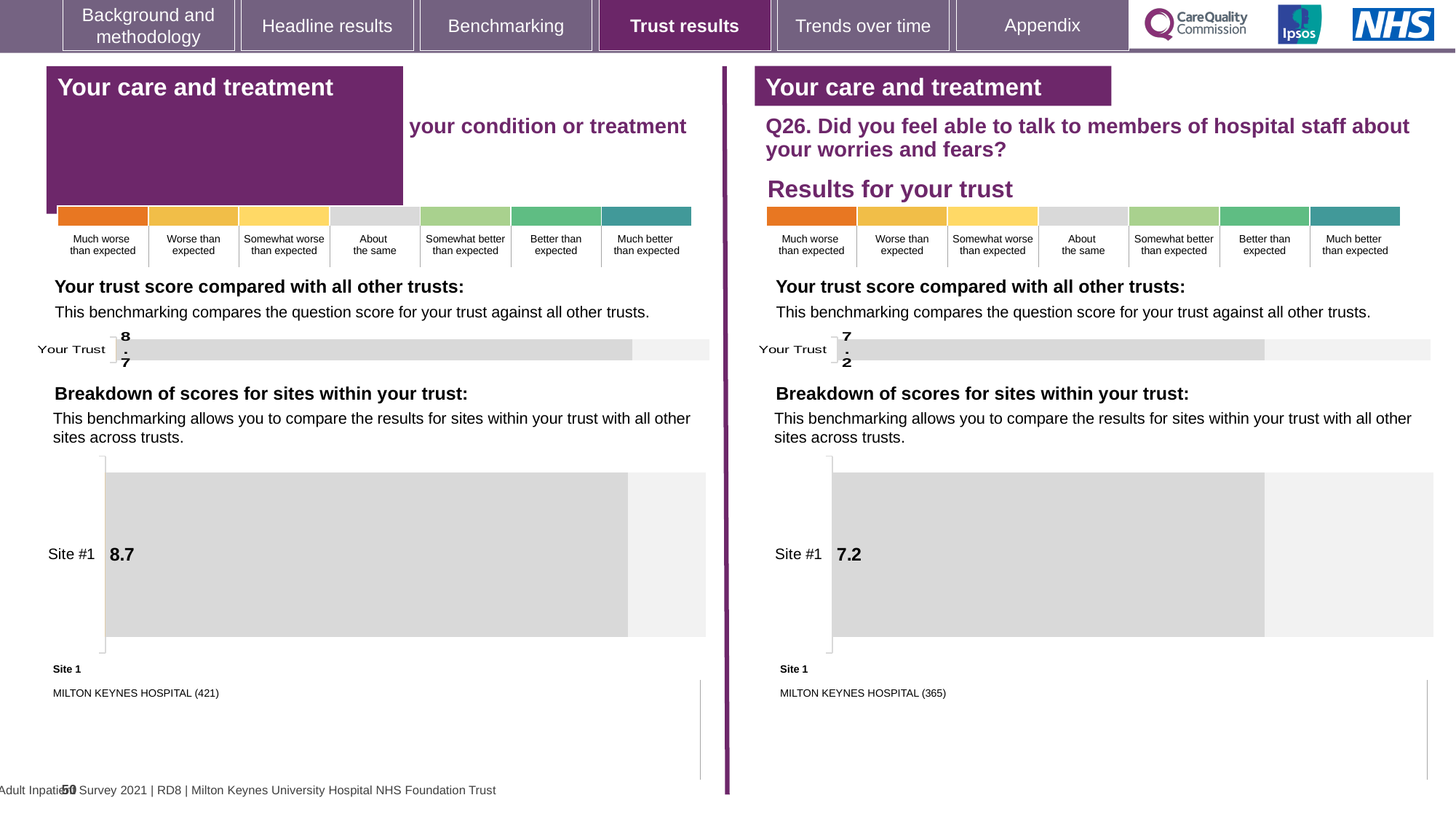
How many sites are shown in the 'Breakdown of scores for sites within your trust' chart on the left panel? 1 On the left panel, what is the score for Site #1 in the 'Breakdown of scores for sites within your trust' chart? 8.7 What type of chart is used to show the Site #1 score on the right panel (Q26)? Bar chart What is the question number and text shown above the charts on the right panel? Q26. Did you feel able to talk to members of hospital staff about your worries and fears? What is the difference between the Site #1 score on the left panel and the Site #1 score on the right panel (Q26)? 1.5 How many sites are shown in the 'Breakdown of scores for sites within your trust' chart on the right panel (Q26)? 1 On the right panel (Q26), what is the score shown for Your Trust in the 'Your trust score compared with all other trusts' chart? 7.2 Which is larger: the Site #1 score on the left panel or the Site #1 score on the right panel (Q26)? Left panel (8.7) On the left panel, what is the score shown for Your Trust in the 'Your trust score compared with all other trusts' chart? 8.7 Which hospital is listed as Site 1 on the right panel (Q26)? MILTON KEYNES HOSPITAL (365) On the right panel (Q26), what is the score for Site #1 in the 'Breakdown of scores for sites within your trust' chart? 7.2